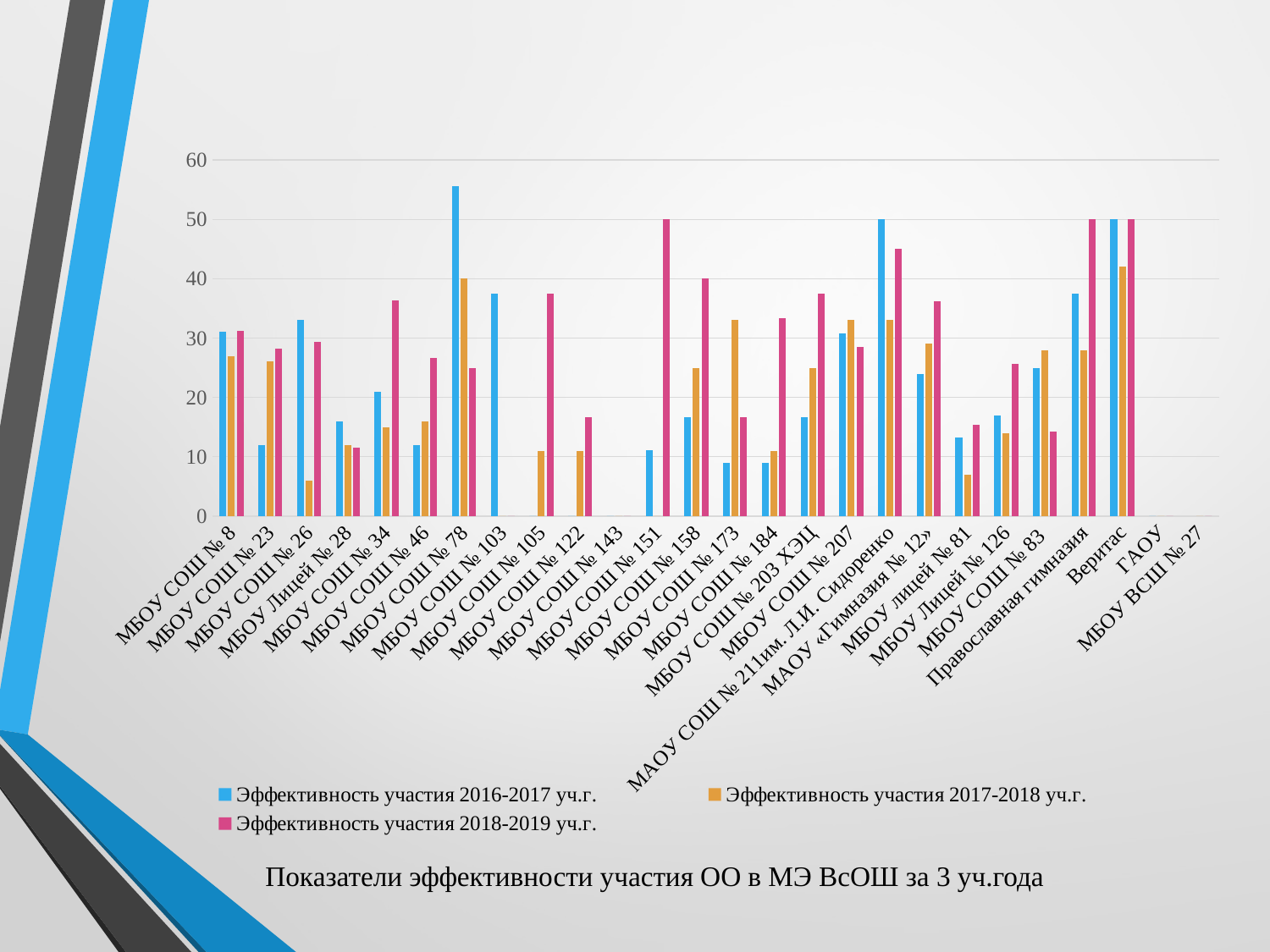
Which series is shown in pink? Эффективность участия 2018-2019 уч.г. What is the title of the chart? Показатели эффективности участия ОО в МЭ ВсОШ за 3 уч.года Which school has the highest value for Эффективность участия 2016-2017 уч.г.? МБОУ СОШ № 78 Is the value for МБОУ СОШ № 151 in Эффективность участия 2018-2019 уч.г. greater or less than 40? greater Is the value for МБОУ СОШ № 78 in Эффективность участия 2016-2017 уч.г. greater or less than 50? greater How many series does the legend list? 3 Which is larger for Эффективность участия 2016-2017 уч.г.: МБОУ СОШ № 8 or МБОУ СОШ № 23? МБОУ СОШ № 8 Is the value for МБОУ СОШ № 26 in Эффективность участия 2017-2018 уч.г. greater or less than 10? less What kind of chart is shown on the slide? bar chart How many categories (schools) are shown on the x axis? 26 Which is larger for Эффективность участия 2018-2019 уч.г.: МБОУ СОШ № 34 or МБОУ Лицей № 28? МБОУ СОШ № 34